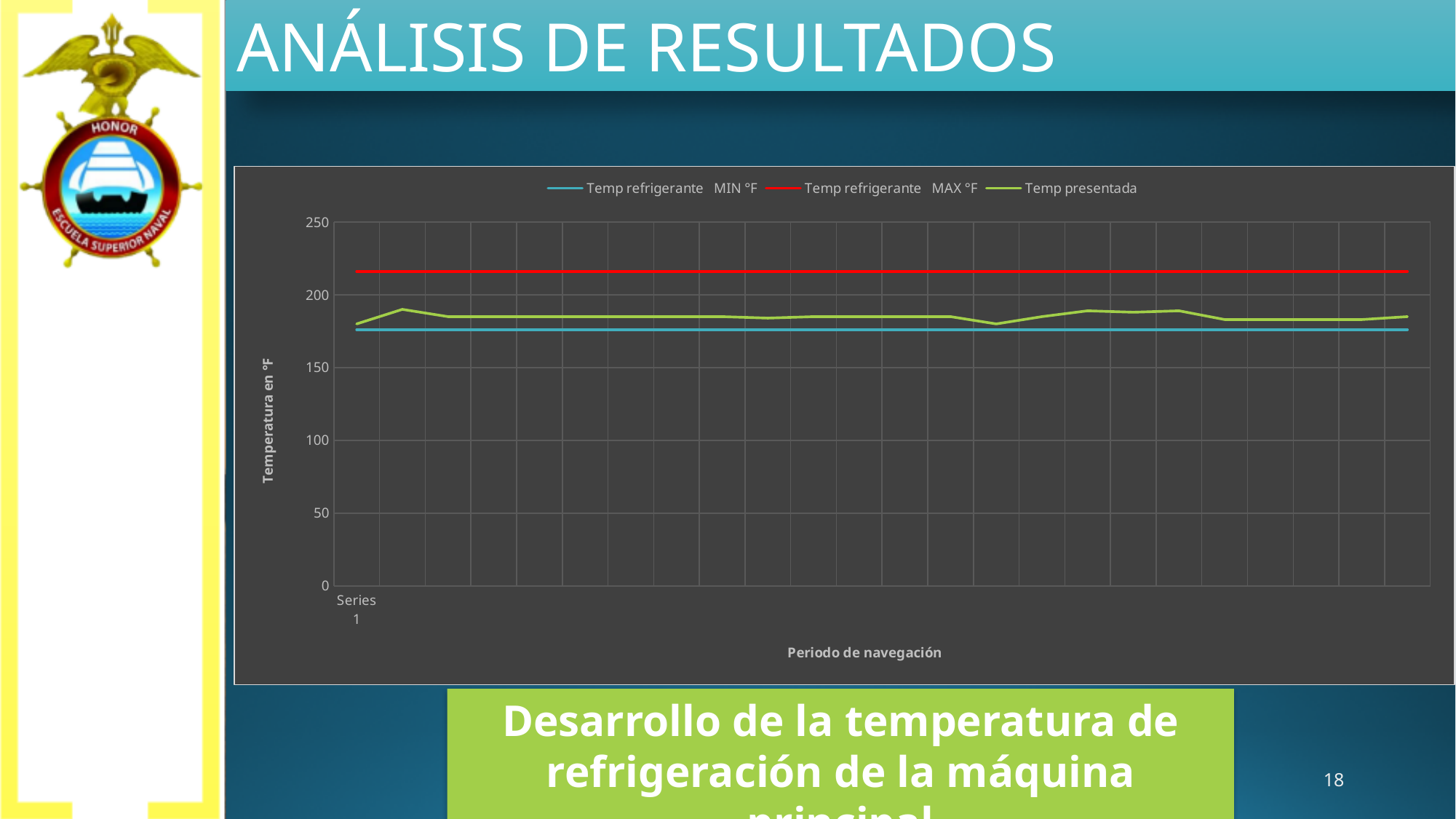
Which of the three series has the highest values on the chart? Temp refrigerante MAX °F Is the value of the Temp refrigerante MAX °F line greater or less than 200? greater What kind of chart is shown on the slide? line chart Are the values of the Temp presentada line greater or less than 150? greater Which line is higher, Temp refrigerante MAX °F or Temp refrigerante MIN °F? Temp refrigerante MAX °F Is the value of the Temp refrigerante MIN °F line greater or less than 150? greater What is the title of the vertical axis? Temperatura en °F How many series does the chart legend list? 3 Which series is plotted in red? Temp refrigerante MAX °F Which line is higher, Temp presentada or Temp refrigerante MIN °F? Temp presentada